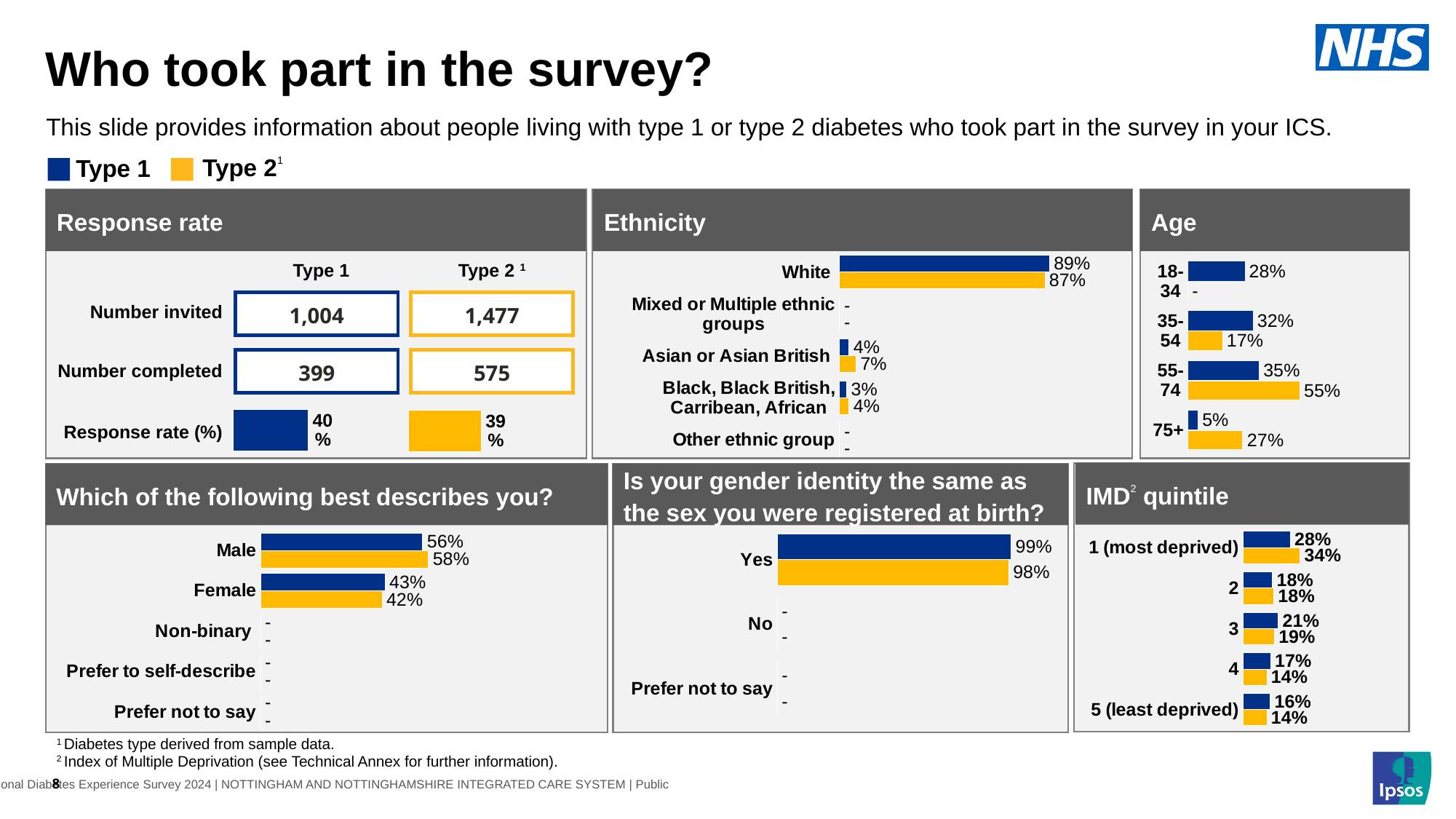
In the Ethnicity chart, what is the Type 1 value for White? 89% In the Age chart, what is the Type 2 value for the 55-74 age group? 55% How many series does the legend at the top of the slide list? 2 In the 'Is your gender identity the same as the sex you were registered at birth?' chart, what is the Type 2 value for Yes? 98% In the IMD quintile chart, what is the difference between the Type 2 and Type 1 values for 1 (most deprived)? 6% In the 'Which of the following best describes you?' chart, which is larger: the Type 1 value for Male or the Type 1 value for Female? Male In the Response rate chart, what is the Response rate (%) for Type 1? 40% In the Age chart, which age group has the highest Type 2 value? 55-74 What kind of chart is the Ethnicity chart? Bar chart In the Response rate chart, what is the Number completed for Type 2? 575 In the Age chart, which age group has the lowest Type 1 value? 75+ How many categories are shown in the IMD quintile chart? 5